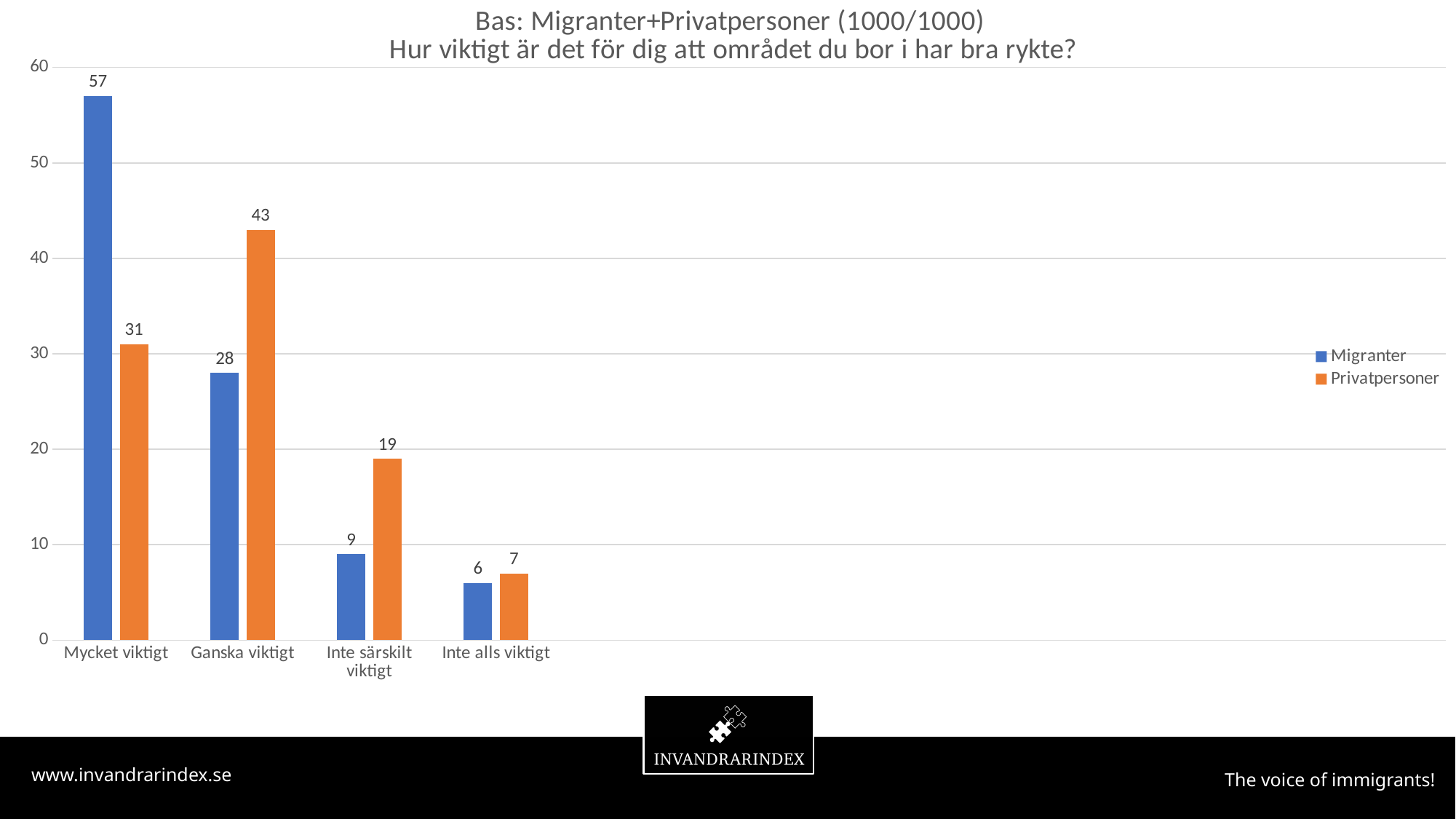
How many series does the legend list? 2 Which colour represents the Privatpersoner series? orange Which category has the lowest value for Privatpersoner? Inte alls viktigt Is the value for Privatpersoner in the Mycket viktigt category greater or less than 40? less What is the value for Privatpersoner in the Inte särskilt viktigt category? 19 Which is larger in the Ganska viktigt category, Migranter or Privatpersoner? Privatpersoner What kind of chart is shown on the slide? bar chart How many categories are shown on the x axis? 4 What is the value for Migranter in the Mycket viktigt category? 57 What is the difference between the Migranter and Privatpersoner values in the Mycket viktigt category? 26 Which category has the highest value for Migranter? Mycket viktigt What is the value for Privatpersoner in the Ganska viktigt category? 43